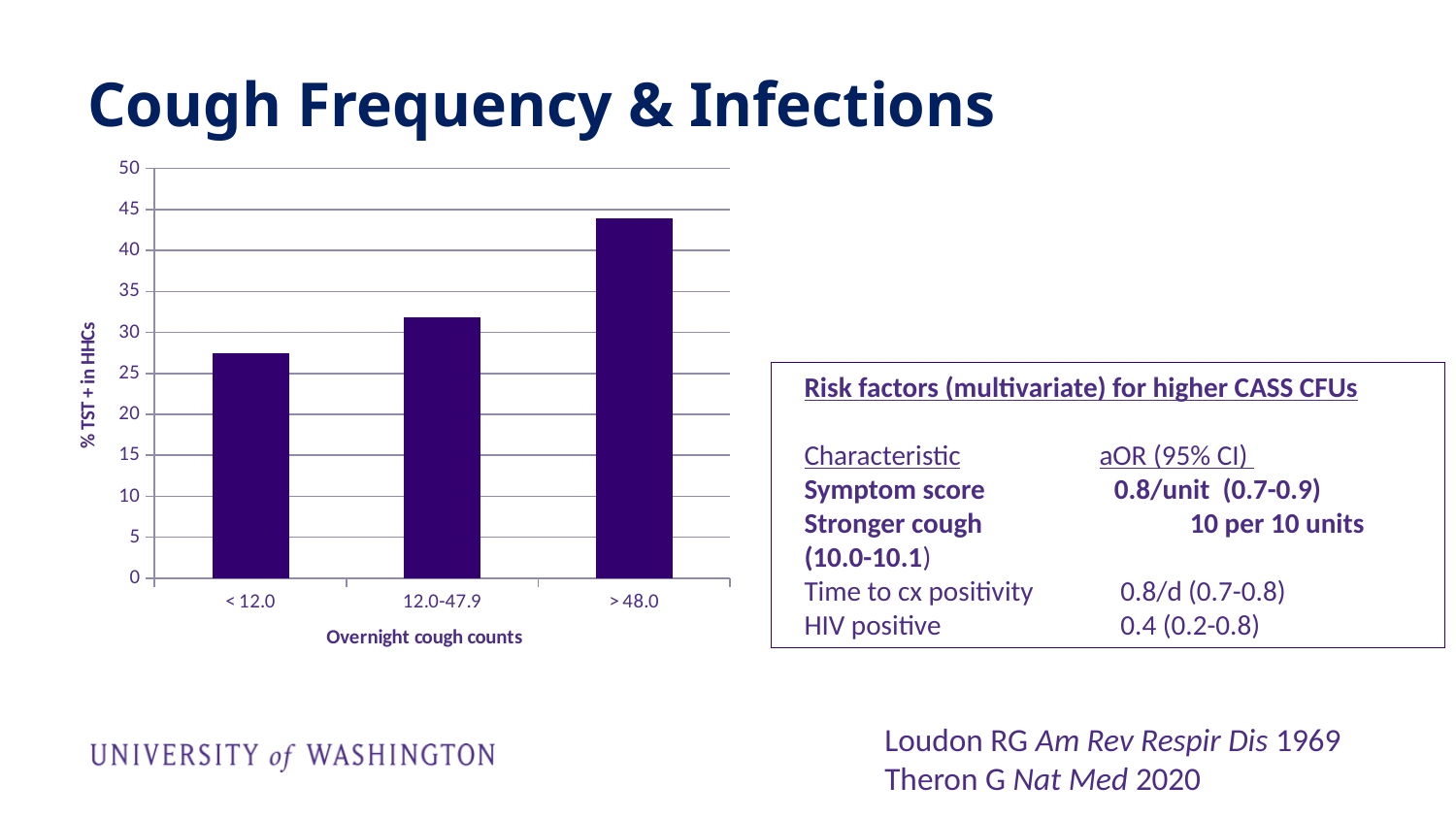
Which overnight cough count category has the highest % TST + in HHCs? > 48.0 Is the % TST + in HHCs for the 12.0-47.9 category greater or less than 30? greater Is the % TST + in HHCs for the > 48.0 category greater or less than 45? less Does the % TST + in HHCs rise or fall as overnight cough counts increase along the x axis? rise How many overnight cough count categories are plotted in the chart? 3 What is the label of the y axis of the chart? % TST + in HHCs Is the % TST + in HHCs for the > 48.0 category greater or less than 40? greater Which has a higher % TST + in HHCs: the 12.0-47.9 category or the > 48.0 category? > 48.0 Which overnight cough count category has the lowest % TST + in HHCs? < 12.0 What is the label of the x axis of the chart? Overnight cough counts What kind of chart is shown on the slide? bar chart